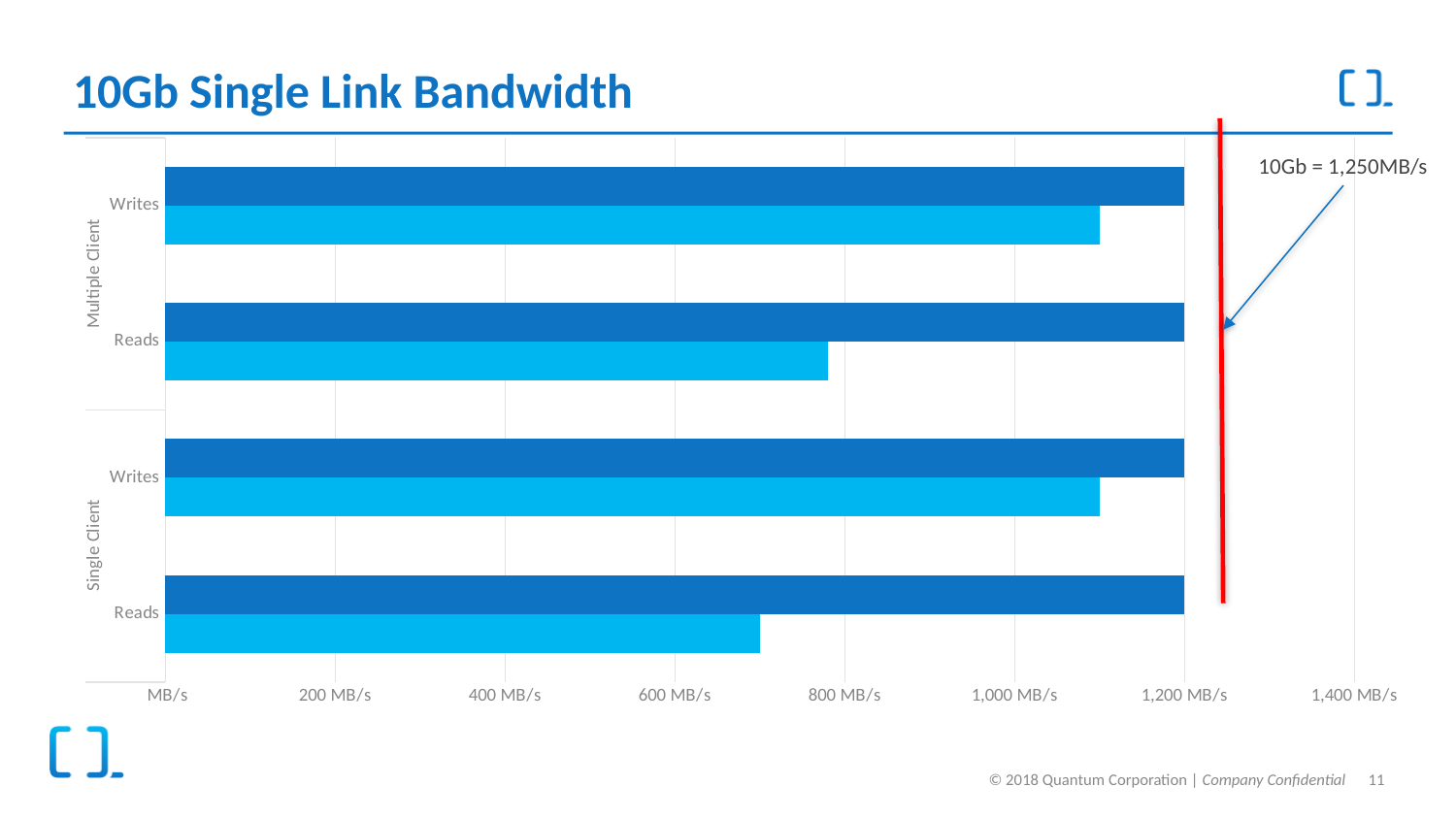
What type of chart is shown on the slide? bar chart Is the light blue bar for Multiple Client Reads greater or less than 800 MB/s? less What is the highest value labelled on the horizontal axis? 1,400 MB/s Is the light blue bar for Single Client Reads greater or less than 800 MB/s? less What does the annotation next to the red line say? 10Gb = 1,250MB/s What value does the dark blue bar for Multiple Client Writes reach? 1,200 MB/s What value does the dark blue bar for Single Client Reads reach? 1,200 MB/s How many categories (bar groups) are plotted on the chart? 4 For Multiple Client Reads, which bar is longer, the dark blue or the light blue? dark blue Which light blue bar is the shortest on the chart? Single Client Reads What is the title of the chart? 10Gb Single Link Bandwidth Is the light blue bar for Single Client Writes greater or less than 1,000 MB/s? greater